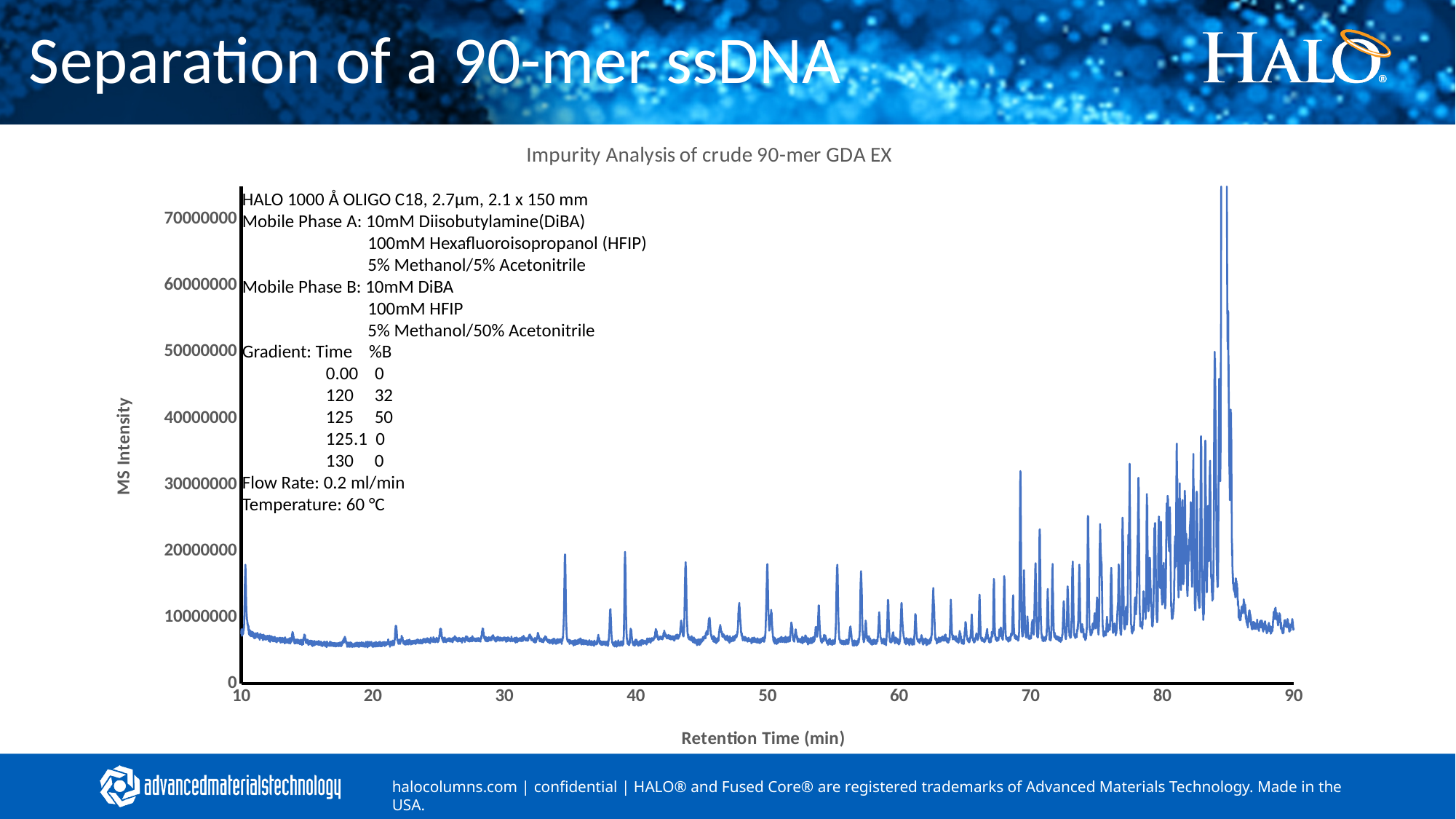
Do the peak intensities generally rise or fall as retention time increases from 10 to 85 min? rise Between which two x-axis tick values does the tallest peak of the chromatogram occur? 80 and 90 Is the intensity of the peak near 81 min greater or less than 30000000? greater Which peak has the higher intensity: the one near 50 min or the tallest peak between 80 and 90 min? the tallest peak between 80 and 90 min Is the intensity of the tallest peak (between 80 and 90 min) greater or less than 70000000? greater What is the label of the x axis of the chart? Retention Time (min) What kind of chart is shown on the slide? line chart Is the baseline intensity at a retention time of 20 min greater or less than 10000000? less What is the title of the chart? Impurity Analysis of crude 90-mer GDA EX Which peak has the higher intensity: the one near 35 min or the one near 69 min? the one near 69 min